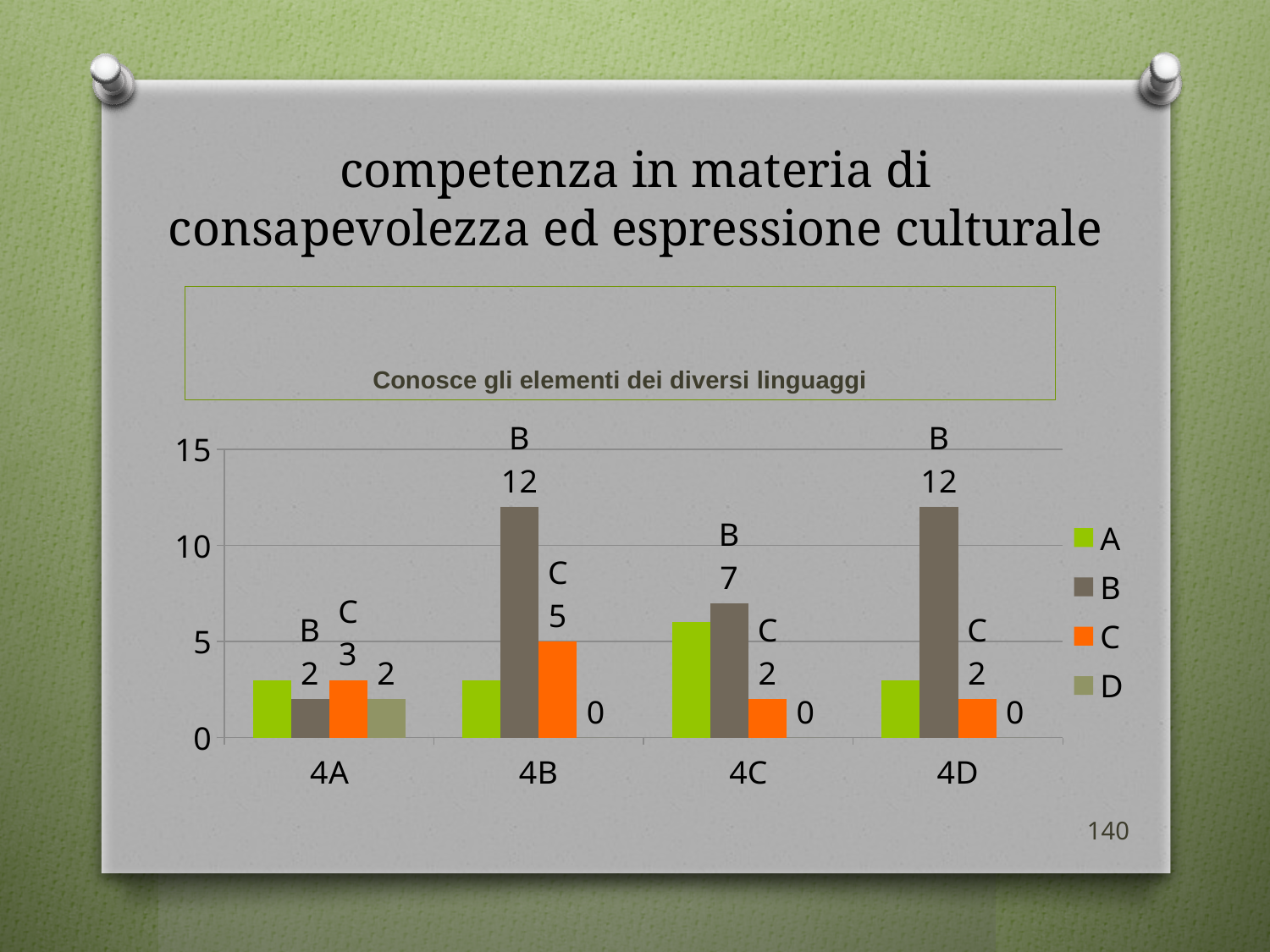
Is the value of series A for class 4C greater or less than 5? greater What is the value of series B for class 4C? 7 Which is larger: series C for 4B or series C for 4C? 4B What kind of chart is shown on the slide? bar chart How many series does the legend list? 4 What is the value of series D for class 4B? 0 What is the difference between series B and series C for class 4B? 7 What is the value of series C for class 4A? 3 Which class has the lowest value for series B? 4A How many classes are shown on the x axis? 4 What is the value of series B for class 4B? 12 Which series has the highest value for class 4B? B